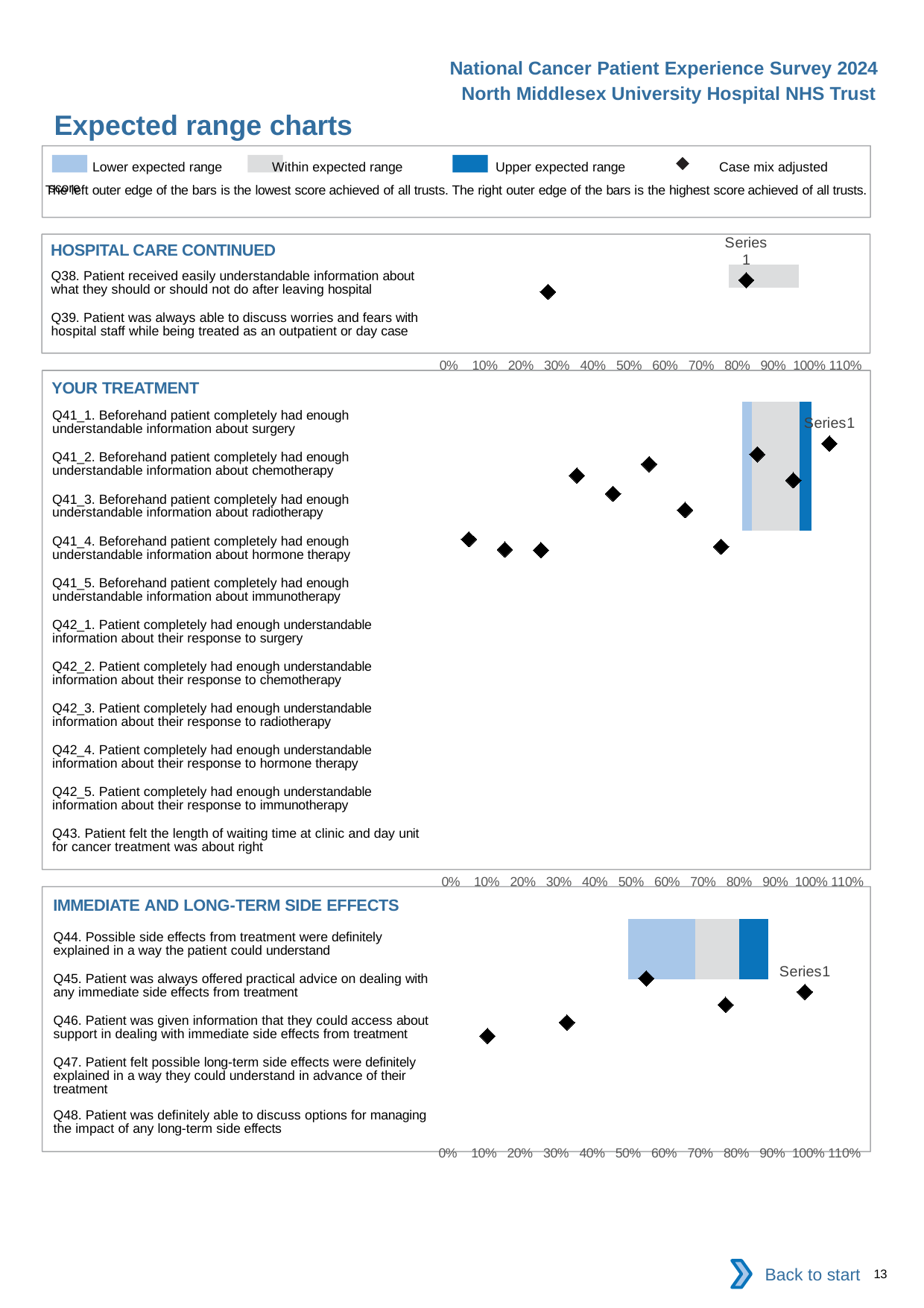
How many diamond markers are plotted in the "IMMEDIATE AND LONG-TERM SIDE EFFECTS" chart? 5 How many question items are listed in the "IMMEDIATE AND LONG-TERM SIDE EFFECTS" chart? 5 In the "HOSPITAL CARE CONTINUED" chart, is the rightmost diamond marker greater or less than 70%? greater How many diamond markers are plotted in the "HOSPITAL CARE CONTINUED" chart? 2 In the "HOSPITAL CARE CONTINUED" chart, is the leftmost diamond marker greater or less than 50%? less In the "IMMEDIATE AND LONG-TERM SIDE EFFECTS" chart, is the leftmost diamond marker greater or less than 30%? less What symbol does the legend use for the case mix adjusted score? A diamond What is the highest tick shown on the x axis of the charts? 110% What kind of chart is used in the "YOUR TREATMENT" section? Bar chart How many entries does the legend at the top of the slide list? 4